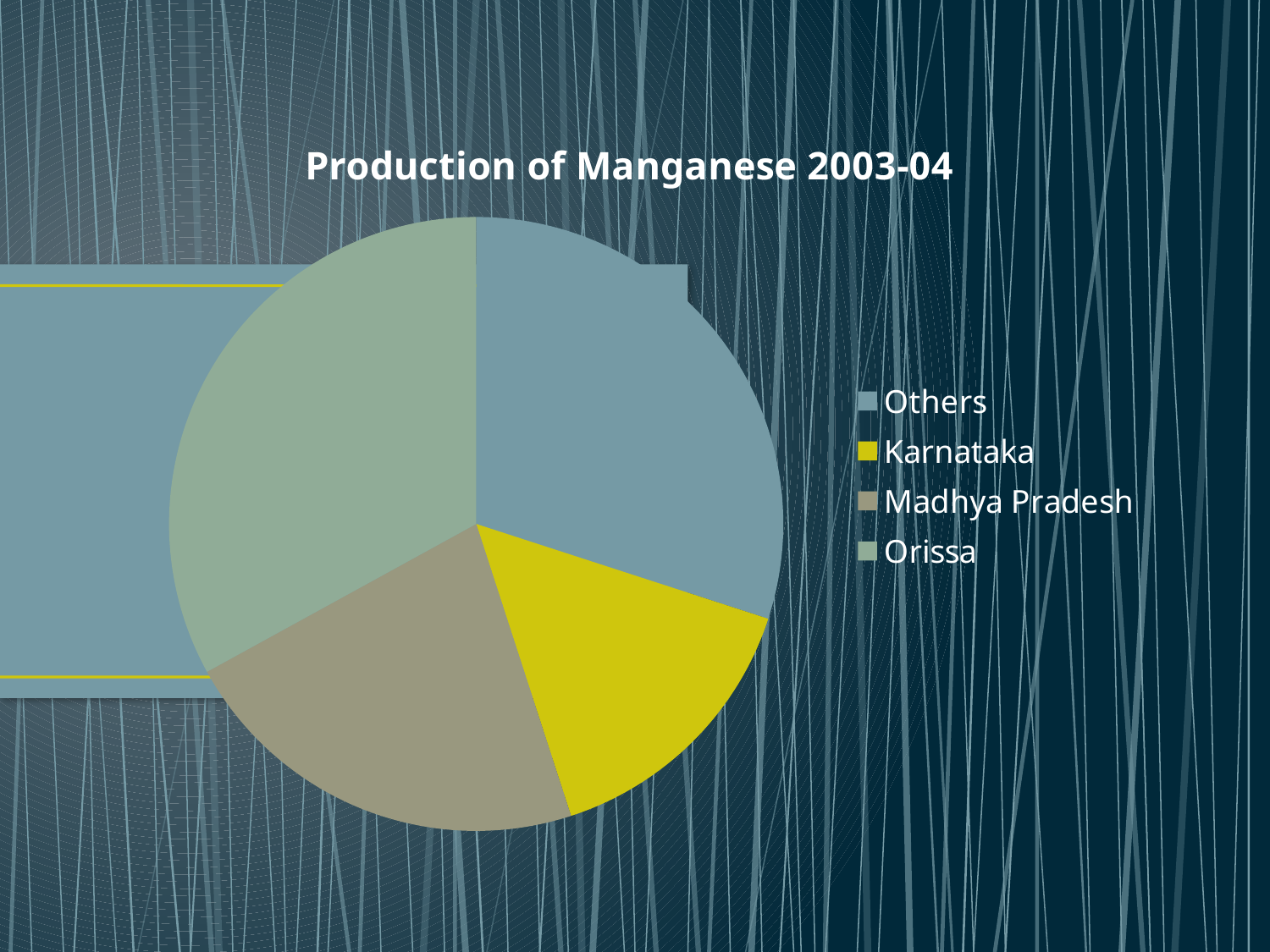
Which slice is larger, Madhya Pradesh or Karnataka? Madhya Pradesh How many slices does the pie chart have? 4 Which slice is larger, Others or Karnataka? Others What kind of chart is shown on the slide? pie chart Which slice is larger, Orissa or Madhya Pradesh? Orissa Which category has the smallest slice of the pie? Karnataka What is the title of the chart? Production of Manganese 2003-04 Which colour represents Karnataka in the pie chart? yellow How many entries does the legend list? 4